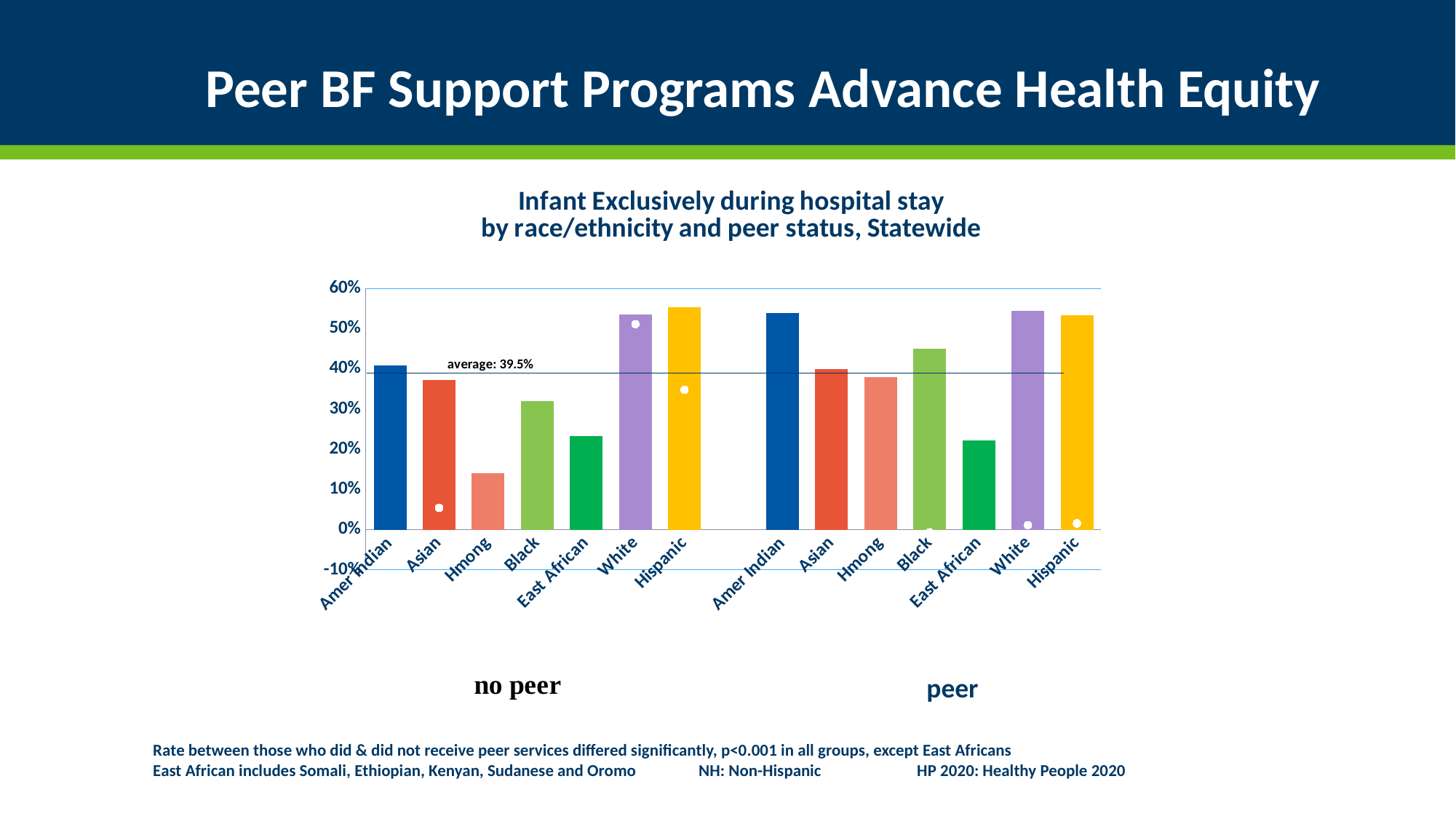
How many race/ethnicity categories are shown in each peer-status group? 7 Which is larger: the value for Amer Indian in the 'no peer' group or in the 'peer' group? peer Which is larger: the value for Hmong in the 'no peer' group or in the 'peer' group? peer Is the value for Hmong in the 'no peer' group greater or less than 20%? less Which race/ethnicity has the lowest value in the 'peer' group? East African Which race/ethnicity has the lowest value in the 'no peer' group? Hmong Is the value for Black in the 'peer' group greater or less than 40%? greater What is the title of the chart? Infant Exclusively during hospital stay by race/ethnicity and peer status, Statewide Is the value for White in the 'no peer' group greater or less than 50%? greater What average value is marked by the horizontal line on the chart? 39.5% How many bars are plotted on the chart in total? 14 What kind of chart is shown on the slide? bar chart